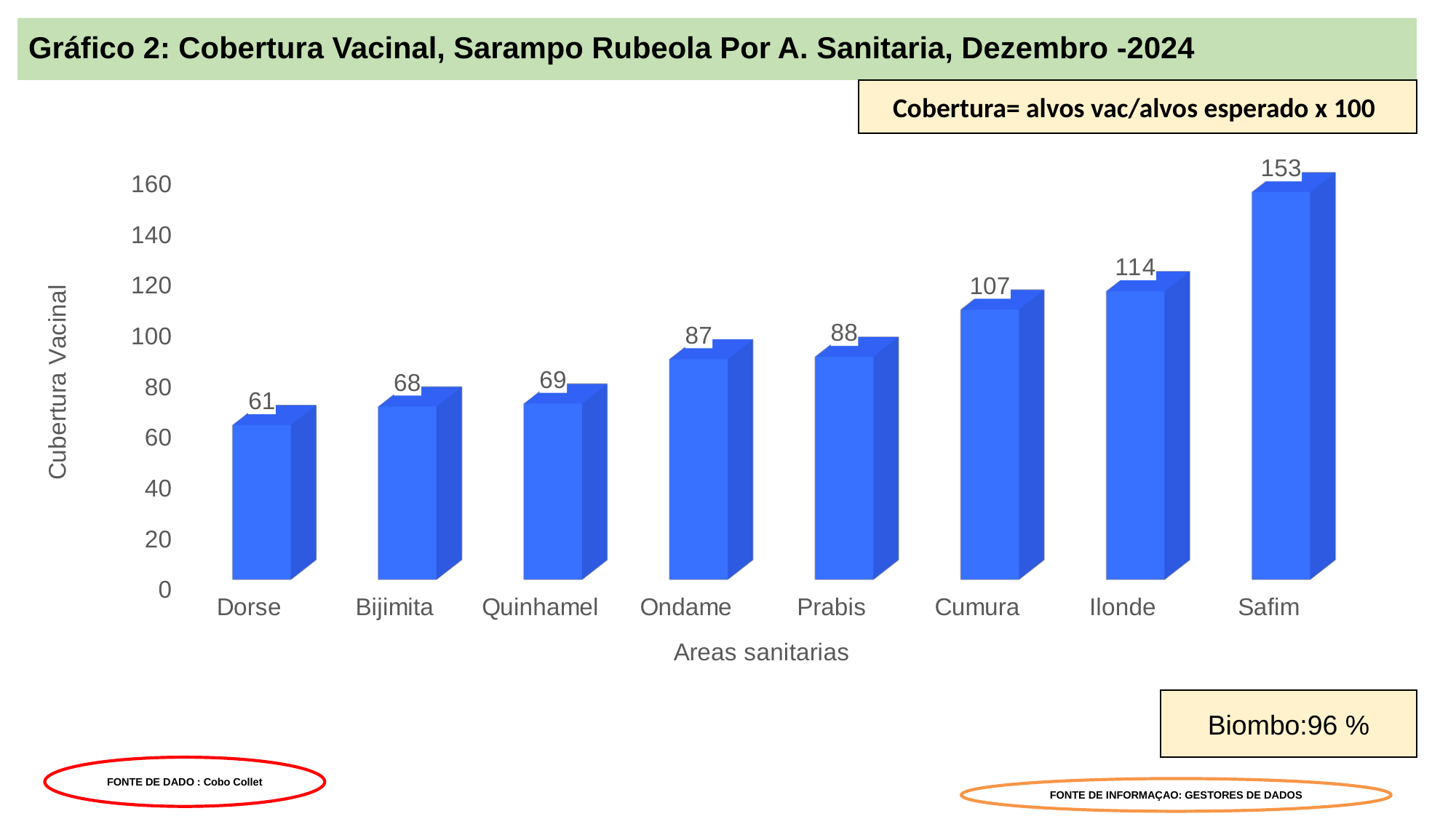
How many health areas are shown on the x axis? 8 Which has a higher coverage value, Bijimita or Prabis? Prabis Do the values generally rise or fall from Dorse to Safim along the x axis? Rise What is the label of the x axis? Areas sanitarias What is the vaccination coverage value for Cumura? 107 What is the label of the y axis? Cubertura Vacinal Which health area has the lowest vaccination coverage? Dorse What is the difference between the coverage values for Safim and Ilonde? 39 What kind of chart is shown on the slide? Bar chart Which health area has the highest vaccination coverage? Safim Is the value for Ilonde greater or less than 100? greater What is the vaccination coverage value for Ondame? 87